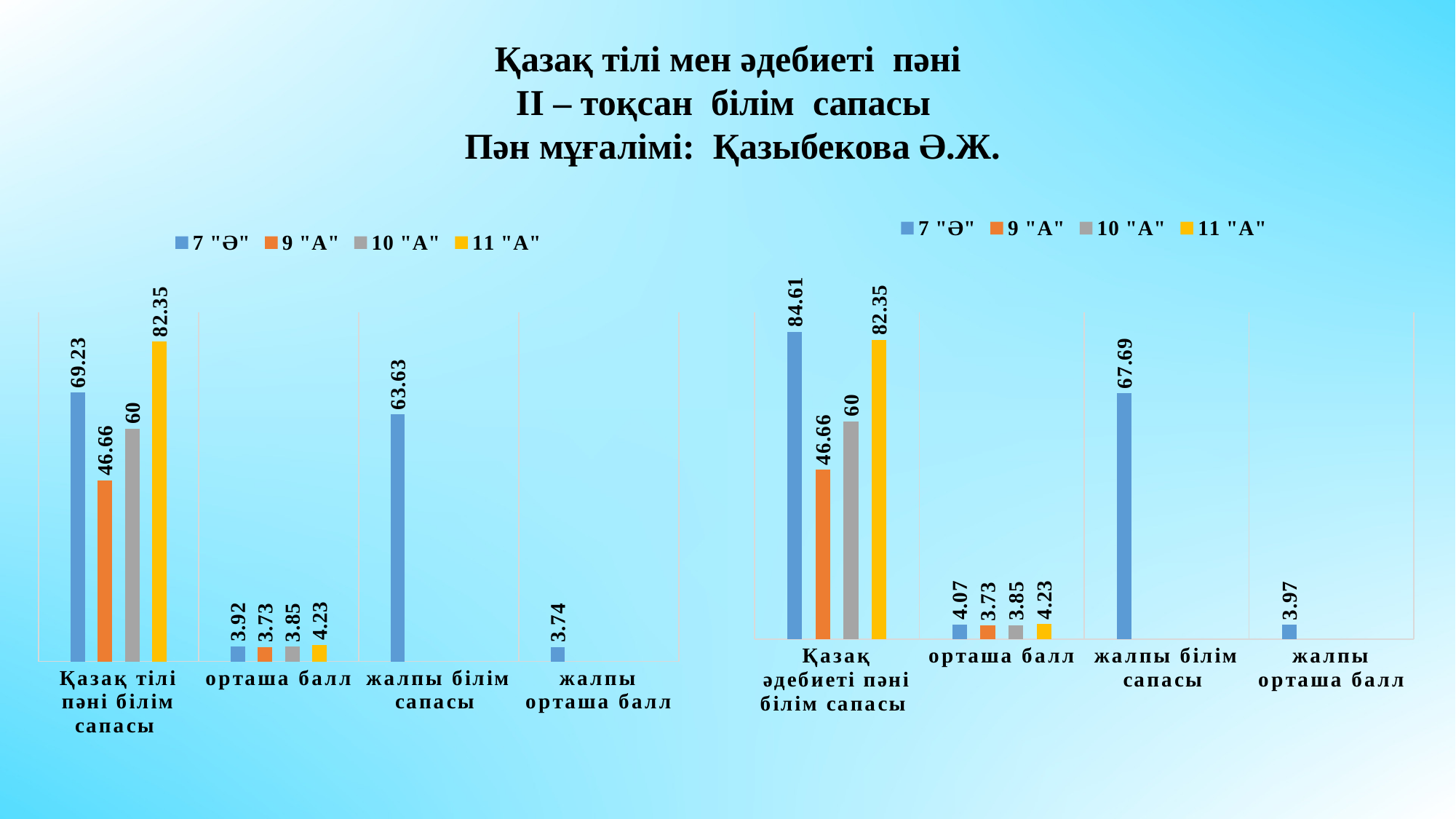
In the right chart, what is the value for 7 "Ә" in the "Қазақ әдебиеті пәні білім сапасы" category? 84.61 In the left chart, what is the difference between the 11 "А" and 7 "Ә" values in the "Қазақ тілі пәні білім сапасы" category? 13.12 In the left chart, which series has the highest value in the "Қазақ тілі пәні білім сапасы" category? 11 "А" What kind of chart is the left chart? Bar chart How many series does the legend of the left chart list? 4 In the right chart, what is the value for 7 "Ә" in the "жалпы орташа балл" category? 3.97 In the left chart, what is the value for 7 "Ә" in the "жалпы білім сапасы" category? 63.63 In the left chart, what is the value for 11 "А" in the "Қазақ тілі пәні білім сапасы" category? 82.35 In the right chart, what is the value for 7 "Ә" in the "орташа балл" category? 4.07 How many categories are shown on the x axis of the right chart? 4 In the right chart, which is larger in the "Қазақ әдебиеті пәні білім сапасы" category: 7 "Ә" or 11 "А"? 7 "Ә" In the right chart, which series has the lowest value in the "Қазақ әдебиеті пәні білім сапасы" category? 9 "А"